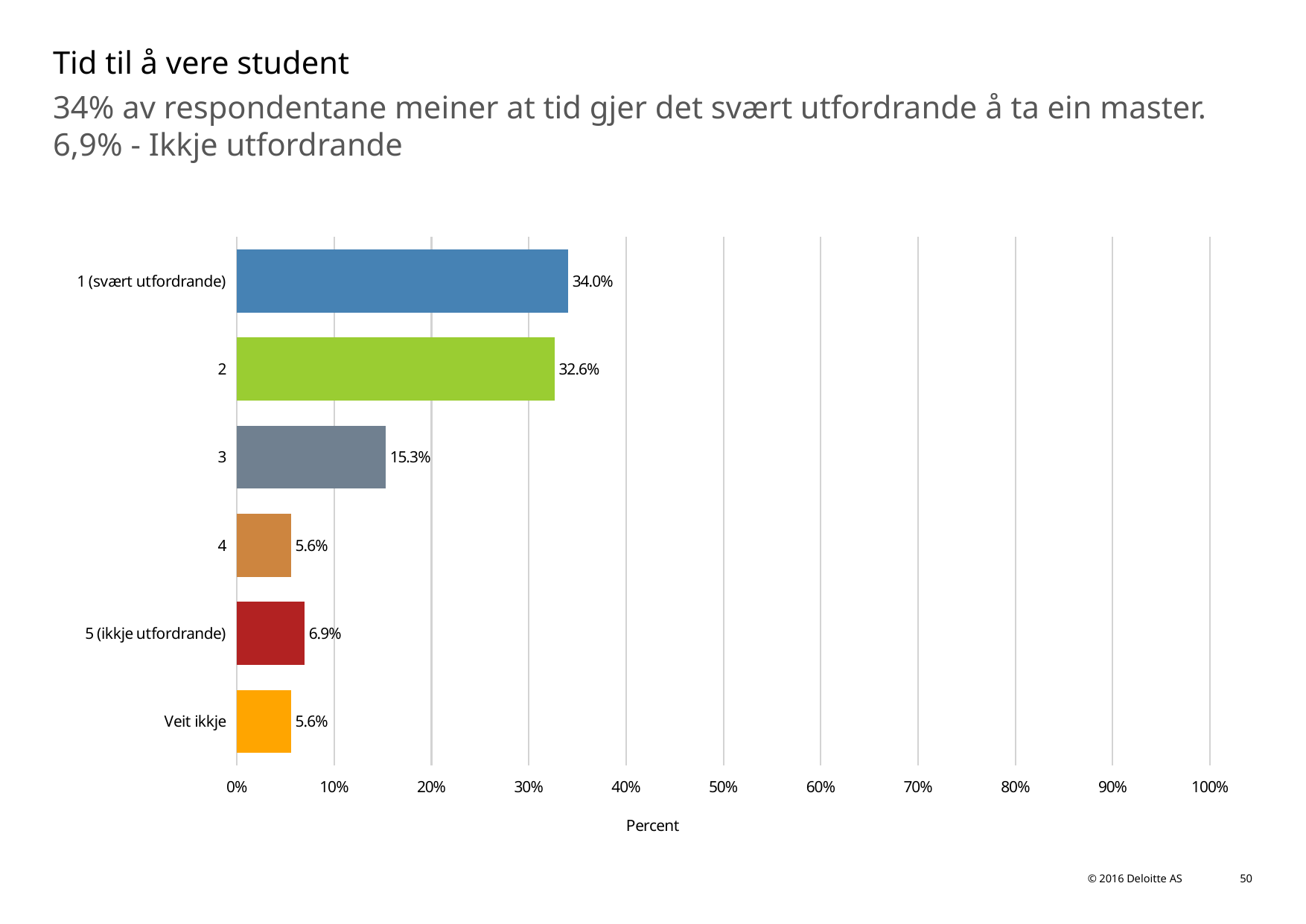
Which category has the highest value? 1 (svært utfordrande) Which is larger, the value for category '3' or the value for category '5 (ikkje utfordrande)'? 3 What is the value for the category 'Veit ikkje'? 5.6% Is the value for category '2' greater or less than 30%? greater What is the value for the category '5 (ikkje utfordrande)'? 6.9% What is the difference between the values for category '2' and category '3'? 17.3% What kind of chart is shown on the slide? bar chart What is the value for the category '1 (svært utfordrande)'? 34.0% What is the value for category '3'? 15.3% What is the difference between the values for category '1 (svært utfordrande)' and category '2'? 1.4% How many categories are shown in the chart? 6 What is the label of the horizontal axis? Percent